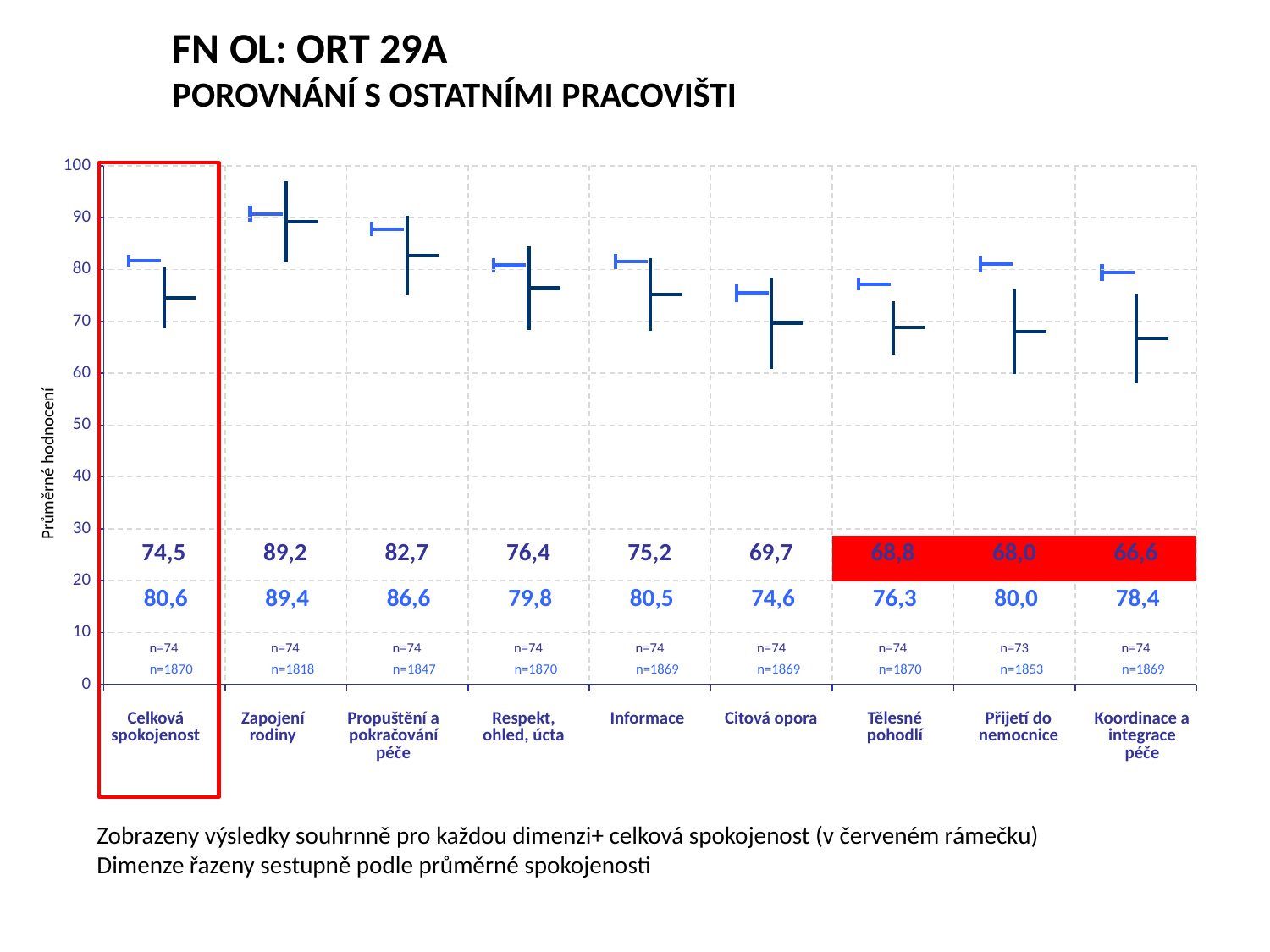
Which category has the highest dark blue value? Zapojení rodiny For Přijetí do nemocnice, which is larger: the dark blue value or the light blue value? the light blue value Which category has the lowest dark blue value? Koordinace a integrace péče Which category is enclosed in the red frame? Celková spokojenost What is the difference between the light blue and dark blue values for Propuštění a pokračování péče? 3,9 What is the light blue value shown for Citová opora? 74,6 What is the difference between the light blue and dark blue values for Celková spokojenost? 6,1 What is the dark blue value shown for Celková spokojenost? 74,5 How many categories are shown on the x axis? 9 Which category has the lowest light blue value? Citová opora What is the light blue value shown for Informace? 80,5 From Zapojení rodiny to Koordinace a integrace péče, do the dark blue values rise or fall along the x axis? fall